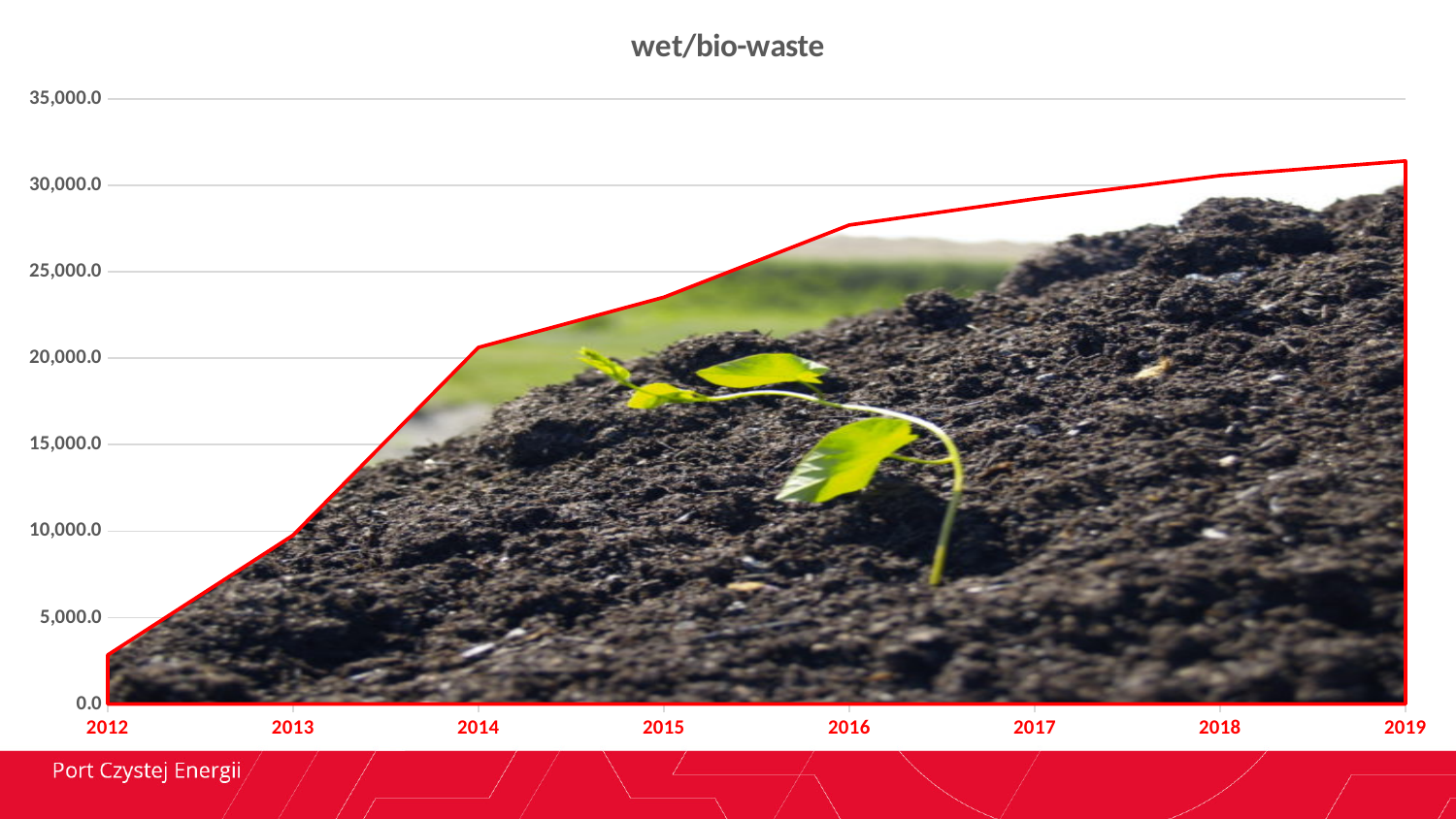
Which year has the larger value, 2013 or 2015? 2015 What is the title of the chart? wet/bio-waste Is the value for 2014 greater or less than 20,000.0? greater Do the wet/bio-waste values rise or fall from 2012 to 2019? rise What kind of chart is shown on the slide? area chart Which year has the lowest wet/bio-waste value? 2012 Is the value for 2019 greater or less than 35,000.0? less Is the value for 2012 greater or less than 5,000.0? less What is the highest value shown on the y axis? 35,000.0 How many years are plotted along the x axis? 8 Which year has the highest wet/bio-waste value? 2019